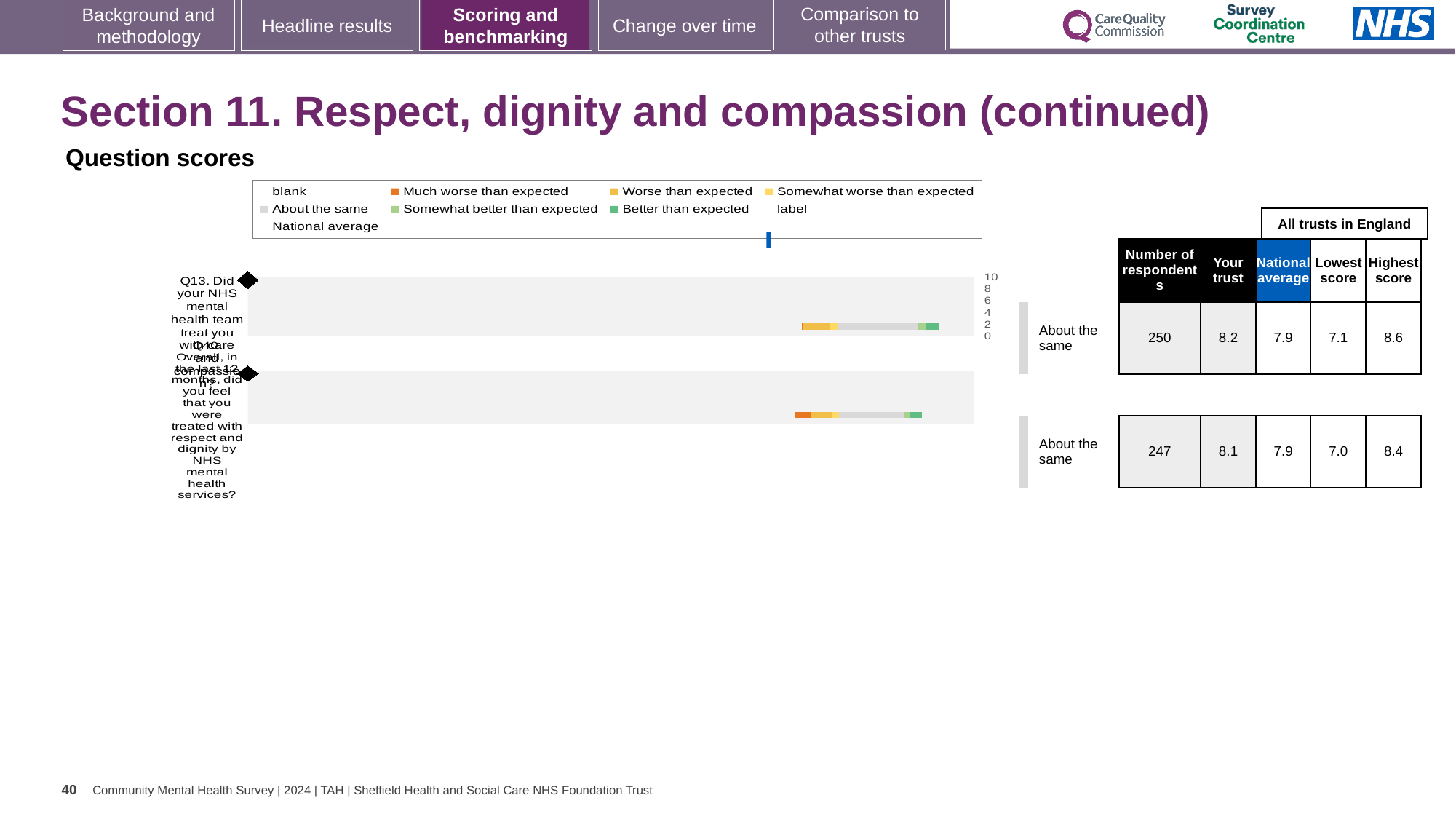
What is the highest score among all trusts in England for Q13? 8.6 What kind of chart is used to show the question scores on this slide? bar chart What is the difference between the 'Your trust' score and the national average for Q13? 0.3 How many respondents answered Q14? 247 How many survey questions are plotted in the question scores chart? 2 What benchmark category is shown for both Q13 and Q14 next to the chart? About the same What colour in the legend represents 'Much worse than expected'? orange What is the national average score for Q13? 7.9 Which question has the higher 'Your trust' score, Q13 or Q14? Q13 What is the lowest score among all trusts in England for Q14? 7.0 What is the 'Your trust' score for Q14 in the question scores table? 8.1 What is the 'Your trust' score for Q13 in the question scores table? 8.2